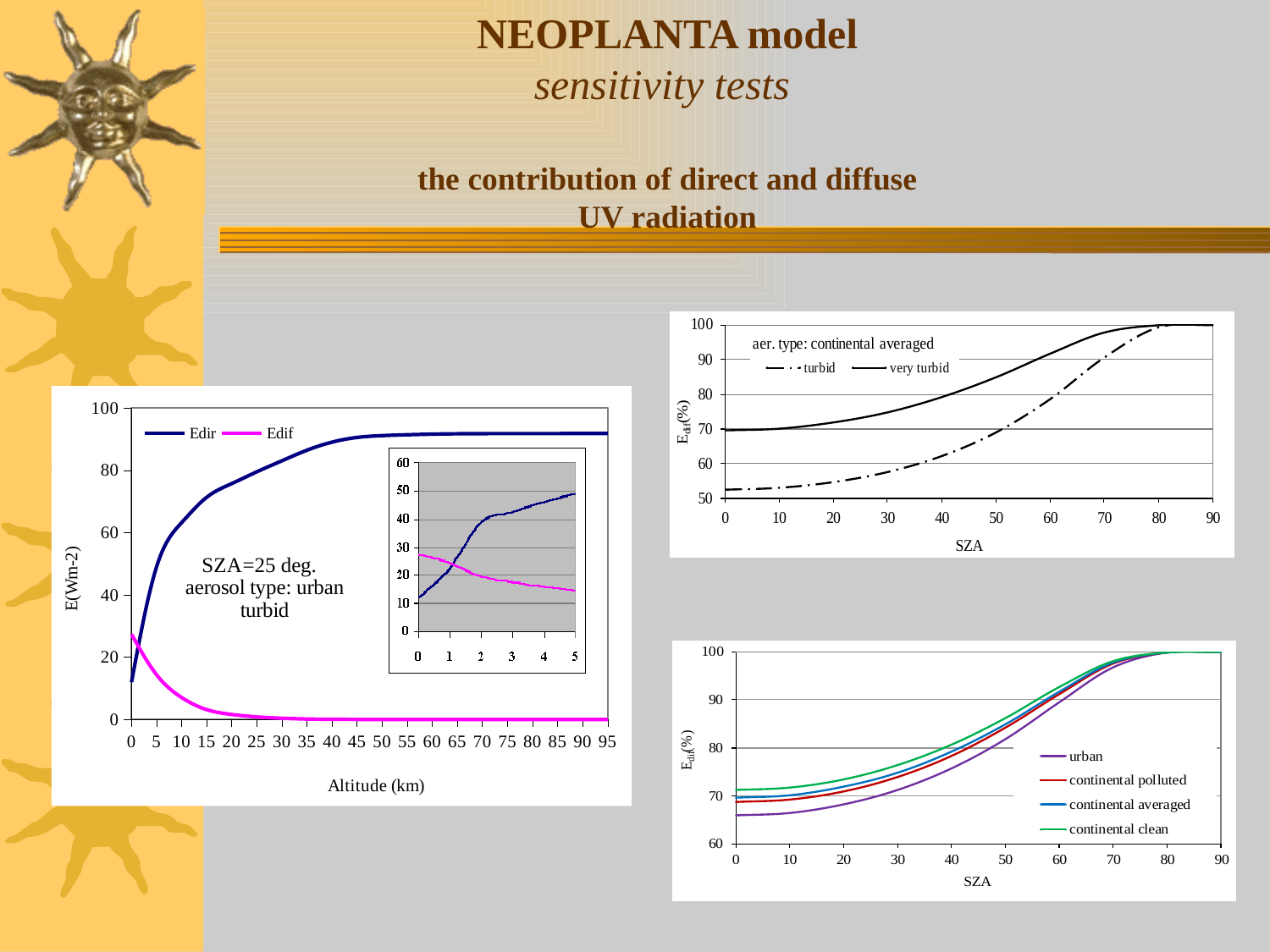
In the top-right chart (aer. type: continental averaged), is the turbid value at SZA 0 greater or less than 60? less How many series does the legend of the bottom-right chart (urban, continental polluted, continental averaged, continental clean) list? 4 In the top-right chart (aer. type: continental averaged), which series has the larger value at SZA 40, turbid or very turbid? very turbid In the left chart (E vs Altitude), is the Edif value at 30 km altitude greater or less than 20? less What is the x-axis label of the left chart? Altitude (km) In the left chart (E vs Altitude), does the Edif series rise or fall as altitude increases? fall In the left chart (E vs Altitude), does the Edir series rise or fall as altitude increases? rise What type of chart is the left chart (E vs Altitude)? line chart How many series does the legend of the left chart (E vs Altitude) list? 2 In the left chart (E vs Altitude), which series has the larger value at altitude 0 km, Edir or Edif? Edif In the left chart (E vs Altitude), is the Edir value at 50 km altitude greater or less than 80? greater How many series does the legend of the top-right chart (aer. type: continental averaged) list? 2